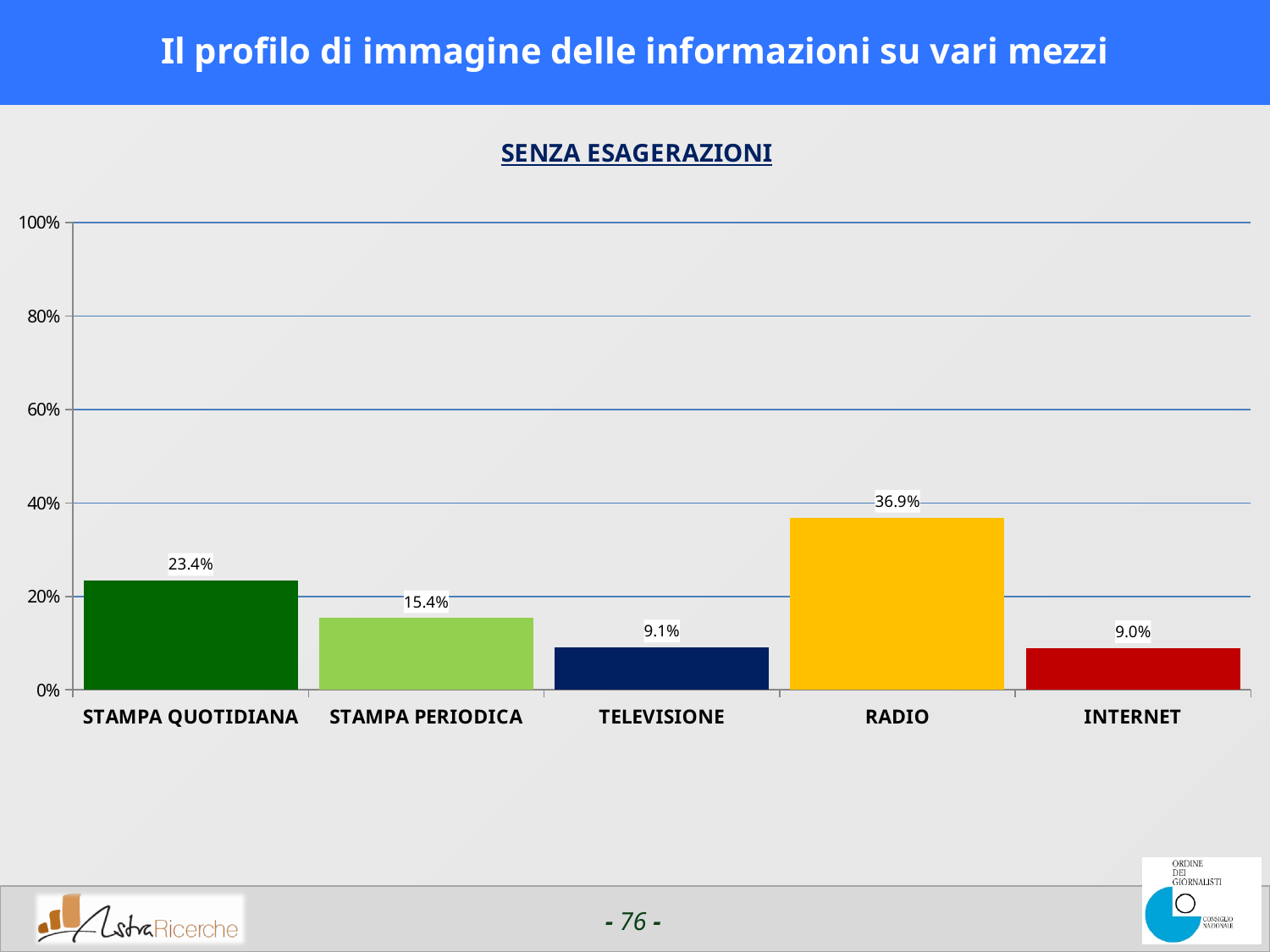
How many categories are shown on the x axis? 5 What is the value for RADIO? 36.9% Is the value for STAMPA QUOTIDIANA greater or less than 20%? greater What kind of chart is shown on the slide? bar chart What is the difference between the values for STAMPA QUOTIDIANA and STAMPA PERIODICA? 8.0% What is the difference between the values for RADIO and STAMPA QUOTIDIANA? 13.5% What is the value for TELEVISIONE? 9.1% What is the value for STAMPA QUOTIDIANA? 23.4% Which category has the highest value? RADIO Is the value for RADIO greater or less than 40%? less What is the title shown above the chart? SENZA ESAGERAZIONI Which is larger, the value for STAMPA PERIODICA or the value for INTERNET? STAMPA PERIODICA